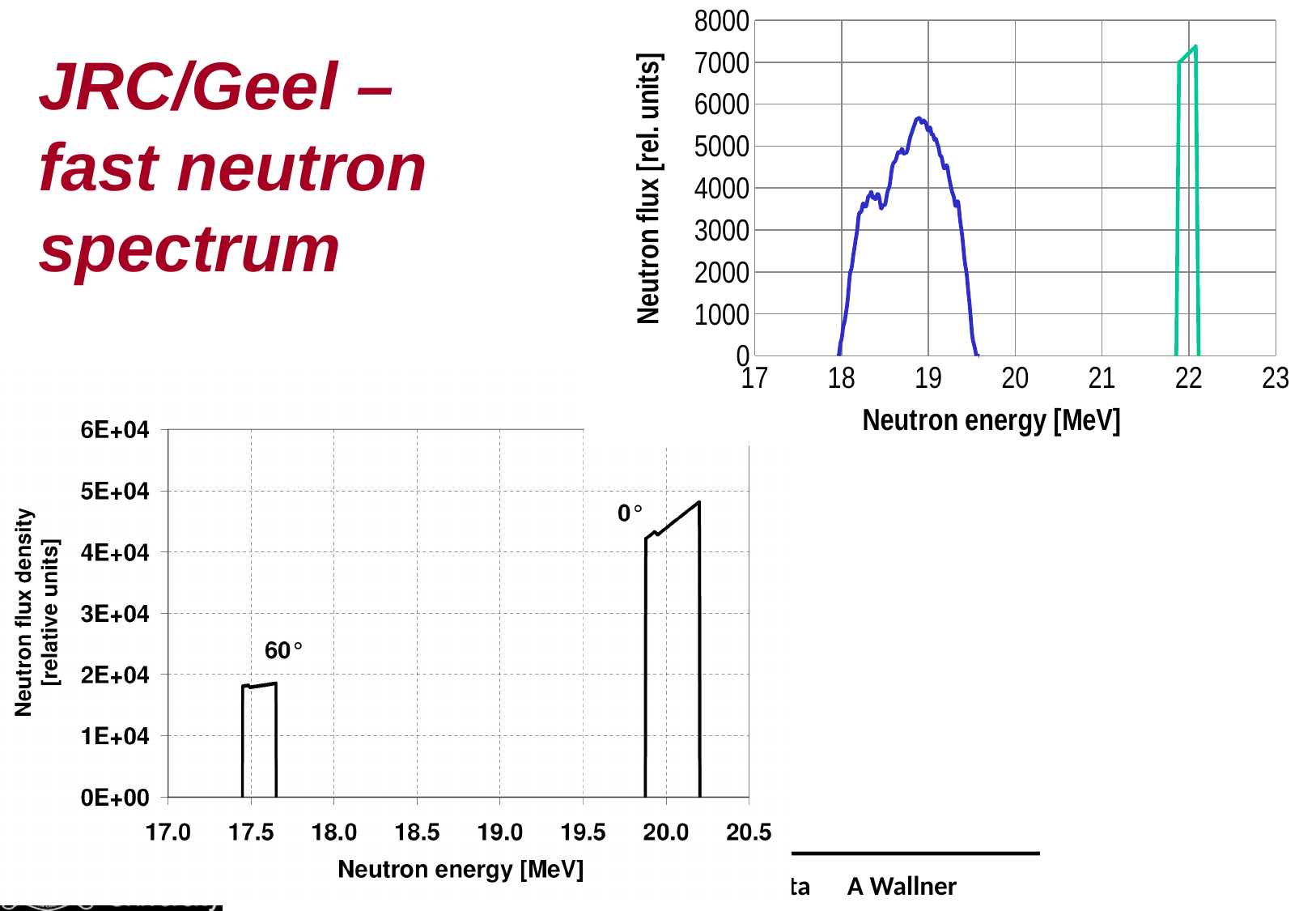
What is the y-axis label of the top-right chart? Neutron flux [rel. units] In the bottom-left chart, is the peak labelled 60° greater or less than 2E+04? less In the top-right chart, is the maximum of the blue curve greater or less than 6000? less In the top-right chart, near which neutron energy value on the x axis is the green peak located? 22 MeV What is the x-axis label of the bottom-left chart? Neutron energy [MeV] In the bottom-left chart, which peak is higher, 0° or 60°? 0° In the top-right chart, which curve reaches a higher neutron flux, the blue one or the green one? the green one In the bottom-left chart, is the peak labelled 0° greater or less than 4E+04? greater How many labelled peaks are shown in the bottom-left chart? 2 What type of chart is the top-right chart (Neutron flux vs Neutron energy)? line chart